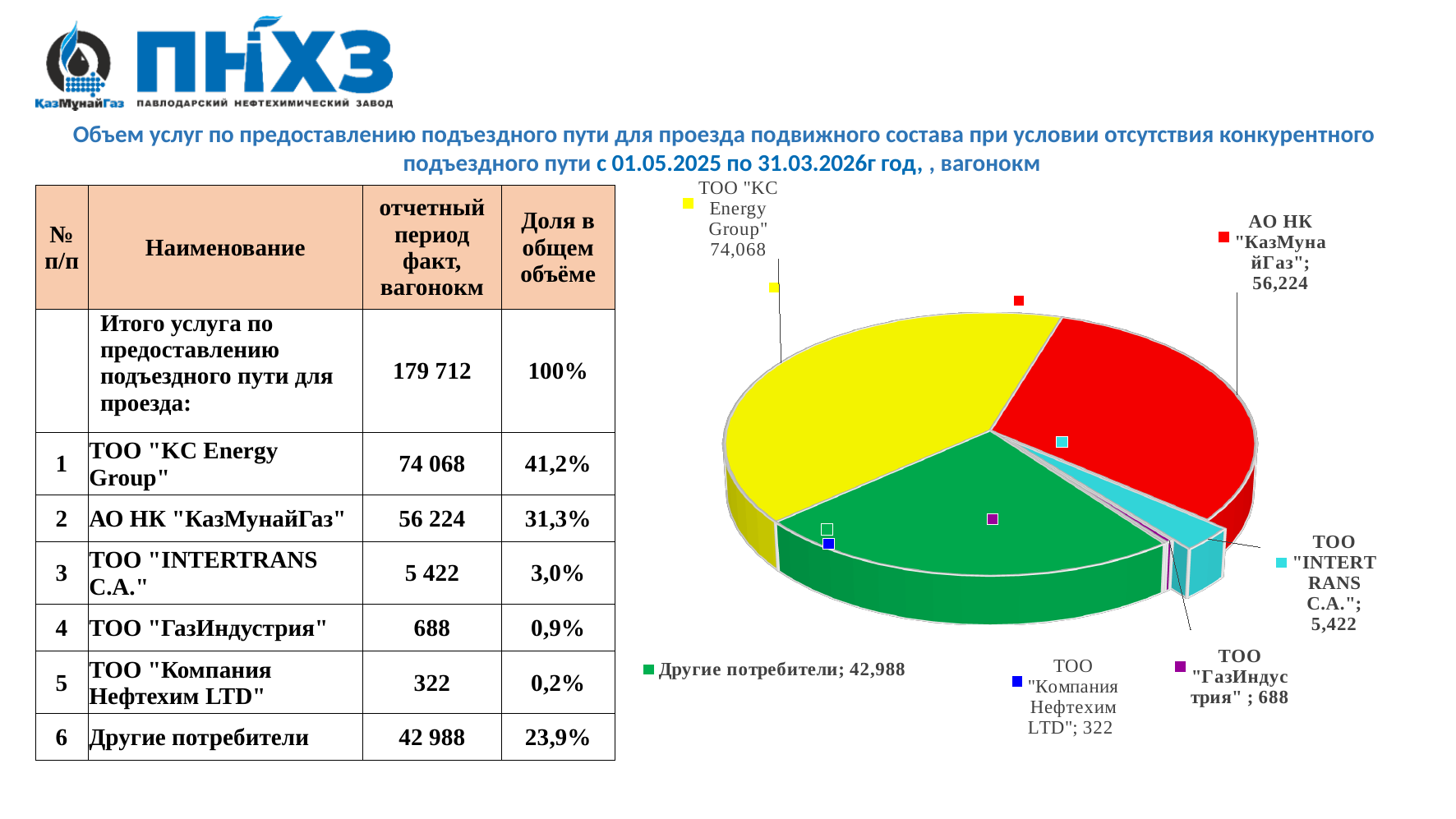
What colour is the slice for Другие потребители in the pie chart? green What is the difference between the values for ТОО "KC Energy Group" and АО НК "КазМунайГаз" in the pie chart? 17,844 What kind of chart is shown on the slide? pie chart What share of the total does ТОО "KC Energy Group" account for, according to the slide? 41,2% What is the value shown for АО НК "КазМунайГаз" in the pie chart? 56,224 Which is larger in the pie chart: Другие потребители or АО НК "КазМунайГаз"? АО НК "КазМунайГаз" How many slices does the pie chart have? 6 What is the value shown for Другие потребители in the pie chart? 42,988 Which slice of the pie chart is the smallest? ТОО "Компания Нефтехим LTD" What is the value shown for ТОО "INTERTRANS C.A." in the pie chart? 5,422 What is the value shown for ТОО "KC Energy Group" in the pie chart? 74,068 Which slice of the pie chart is the largest? ТОО "KC Energy Group"